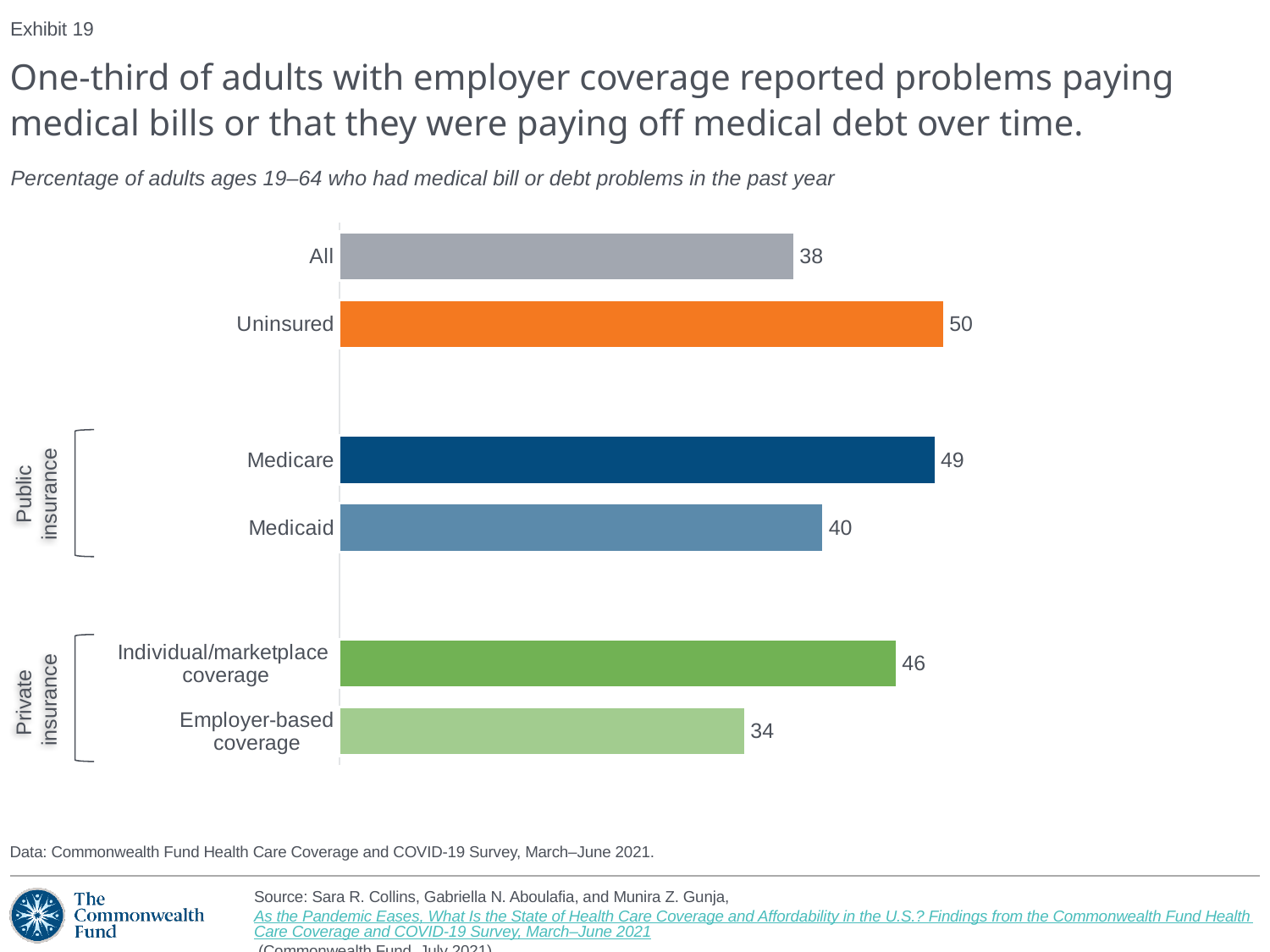
Which is larger, the value for Medicare or the value for Individual/marketplace coverage? Medicare Which two categories are grouped under the 'Public insurance' bracket? Medicare and Medicaid What is the difference between the values for Individual/marketplace coverage and Employer-based coverage? 12 What is the difference between the values for Medicare and Medicaid? 9 What kind of chart is shown on the slide? Bar chart What is the value for Medicaid? 40 What is the value for Uninsured? 50 Which category has the highest value? Uninsured What is the value for All adults? 38 What is the value for Employer-based coverage? 34 How many categories are plotted in the chart? 6 Which category has the lowest value? Employer-based coverage